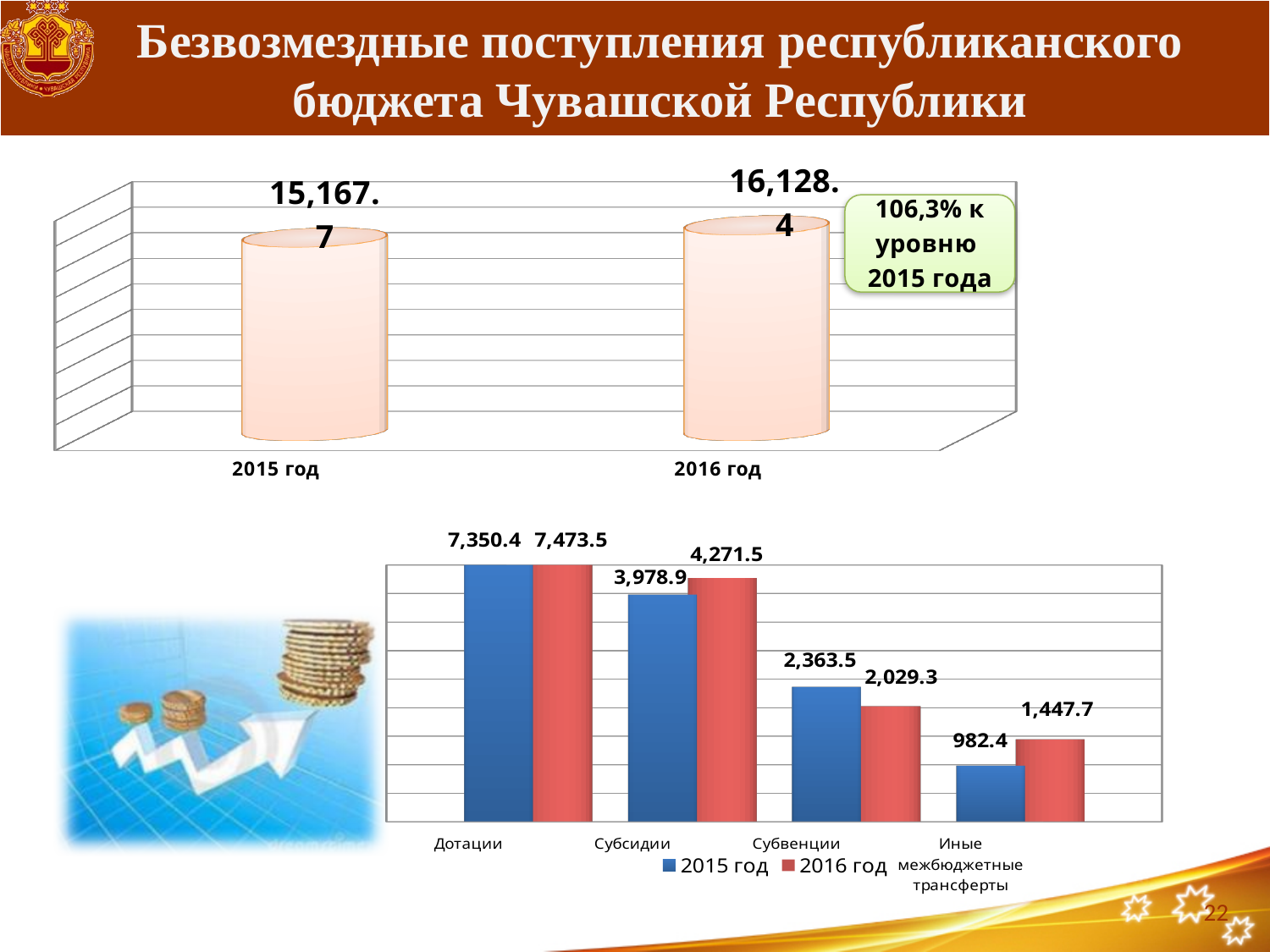
In the bottom chart, what is the value for Субвенции in 2015 год? 2,363.5 In the bottom chart, how many series does the legend list? 2 In the top chart, what is the difference between the 2016 год and 2015 год values? 960.7 In the bottom chart, what is the value for Субсидии in 2016 год? 4,271.5 What kind of chart is the bottom chart? Bar chart In the top chart, what is the value for 2016 год? 16,128.4 In the top chart, how many categories are shown? 2 In the bottom chart, which category has the highest value for 2016 год? Дотации In the bottom chart, which is larger for Субвенции: the 2015 год value or the 2016 год value? 2015 год In the bottom chart, which category has the lowest value for 2015 год? Иные межбюджетные трансферты In the top chart, what is the value for 2015 год? 15,167.7 In the bottom chart, what is the difference between the 2016 год and 2015 год values for Иные межбюджетные трансферты? 465.3